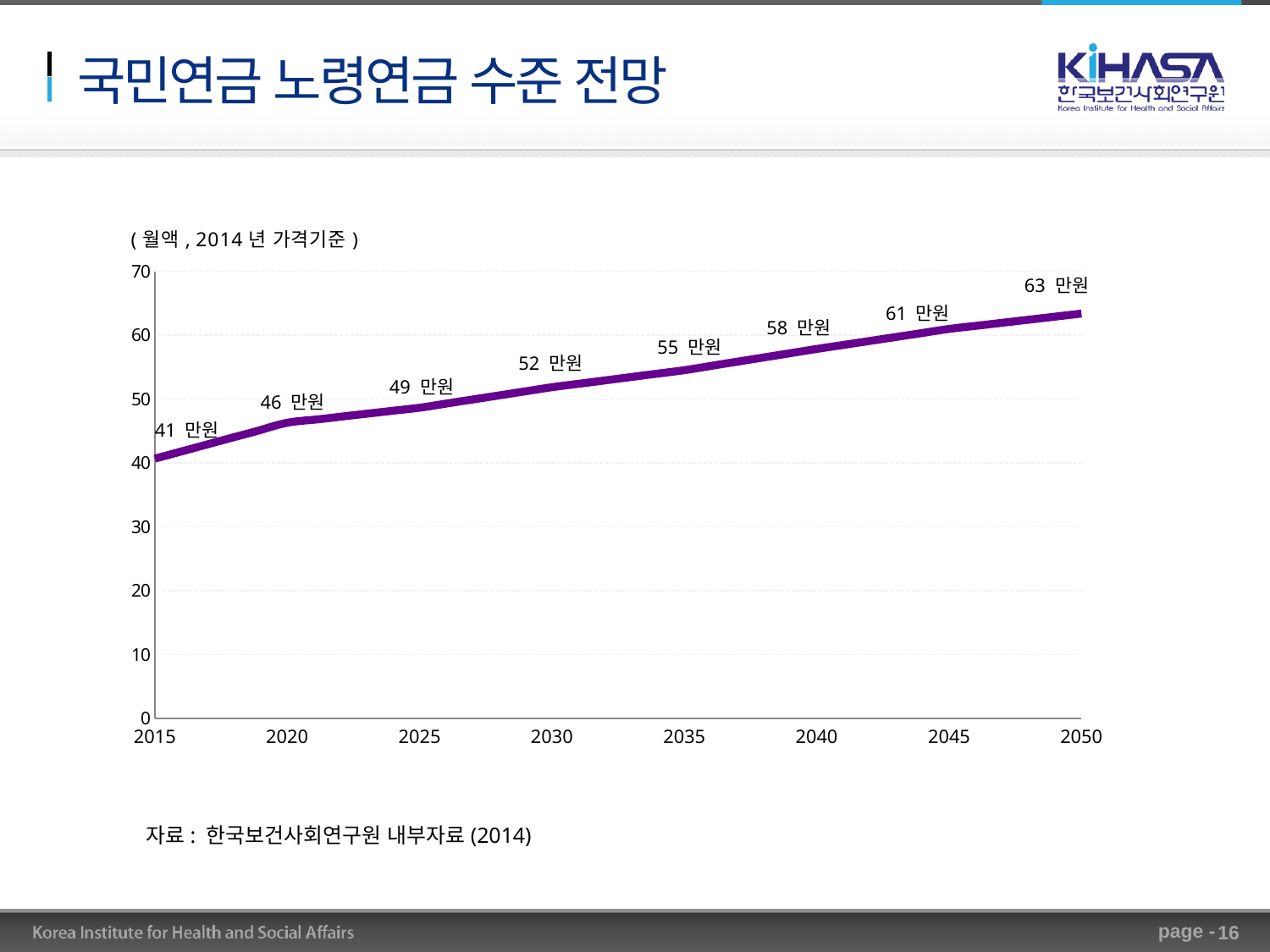
Which is larger, the value for 2045 or the value for 2020? 2045 What is the value for 2030? 52 만원 Is the value for 2035 greater or less than 50? greater What is the value for 2050? 63 만원 What is the value for 2040? 58 만원 What kind of chart is shown on the slide? line chart Which year has the highest value? 2050 What is the value for 2015? 41 만원 Which year has the lowest value? 2015 What is the difference between the values for 2050 and 2015? 22 만원 What is the difference between the values for 2035 and 2025? 6 만원